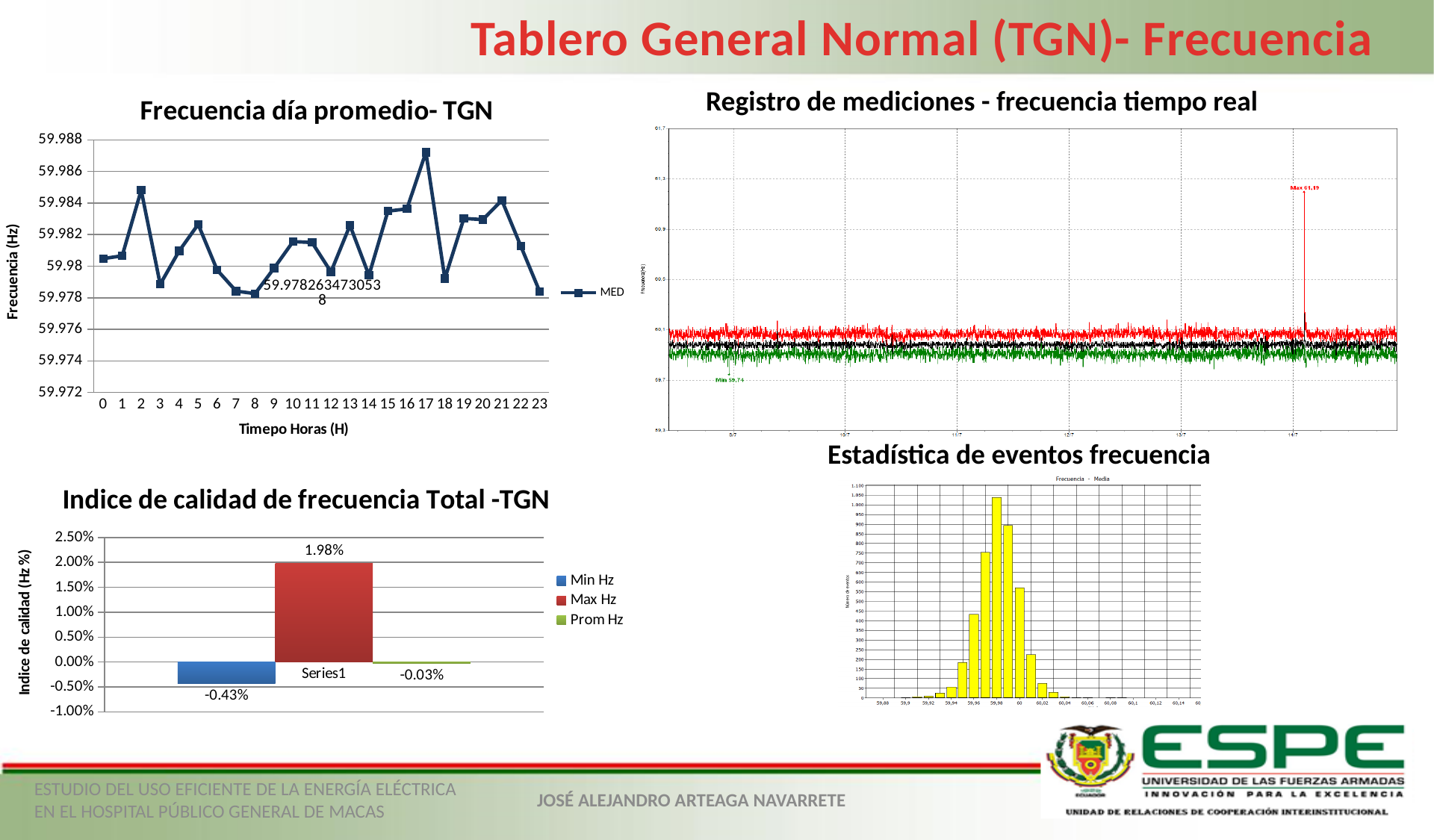
In the chart 'Indice de calidad de frecuencia Total -TGN', what is the value for Min Hz? -0.43% In the chart 'Indice de calidad de frecuencia Total -TGN', what is the value for Prom Hz? -0.03% In the chart 'Frecuencia día promedio- TGN', is the value at hour 3 greater or less than 59.98? less In the chart 'Frecuencia día promedio- TGN', what is the name of the series shown in the legend? MED In the chart 'Frecuencia día promedio- TGN', what value is labelled at hour 8? 59.9782634730538 In the chart 'Frecuencia día promedio- TGN', is the value at hour 17 greater or less than 59.986? greater How many series does the legend of 'Indice de calidad de frecuencia Total -TGN' list? 3 What kind of chart is 'Frecuencia día promedio- TGN'? line chart In the chart 'Frecuencia día promedio- TGN', at which hour is the frequency highest? 17 In the chart 'Indice de calidad de frecuencia Total -TGN', what is the value for Max Hz? 1.98% In the chart 'Frecuencia día promedio- TGN', how many hourly points are plotted? 24 In the chart 'Indice de calidad de frecuencia Total -TGN', what is the difference between the Max Hz and Min Hz values? 2.41%